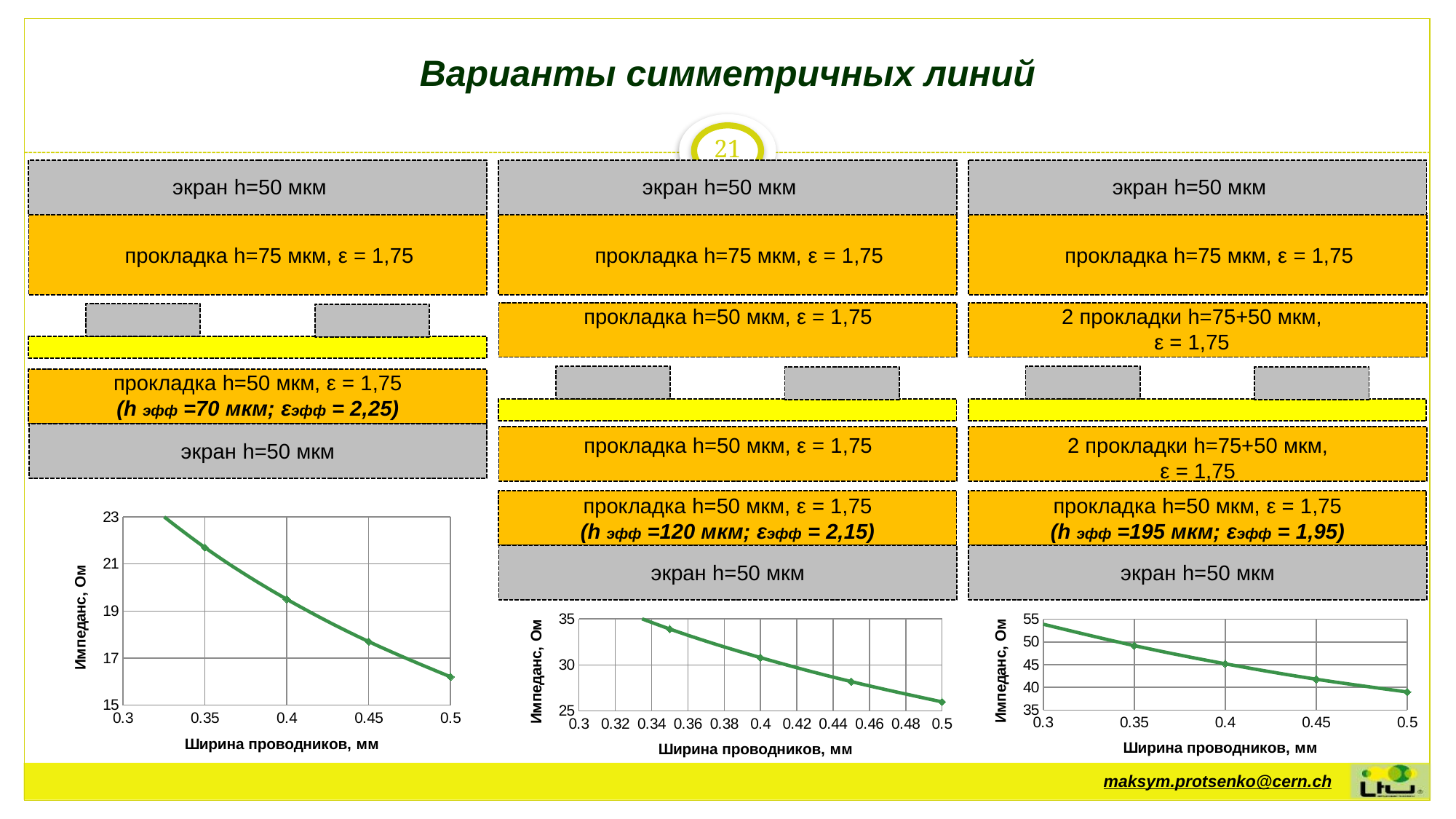
What kind of chart is the left chart at the bottom of the slide? line chart In the right chart, which width has the larger impedance, 0.35 mm or 0.45 mm? 0.35 mm What is the y-axis label of the middle chart? Импеданс, Ом In the left chart, does the impedance rise or fall as the conductor width increases from 0.3 to 0.5 mm? fall In the middle chart, is the value at a width of 0.4 mm greater or less than 30? greater In the right chart, is the value at a width of 0.45 mm greater or less than 45? less In the left chart, which width has the larger impedance, 0.35 mm or 0.5 mm? 0.35 mm In the right chart, is the value at a width of 0.4 mm greater or less than 40? greater In the middle chart, does the impedance rise or fall along the x axis? fall